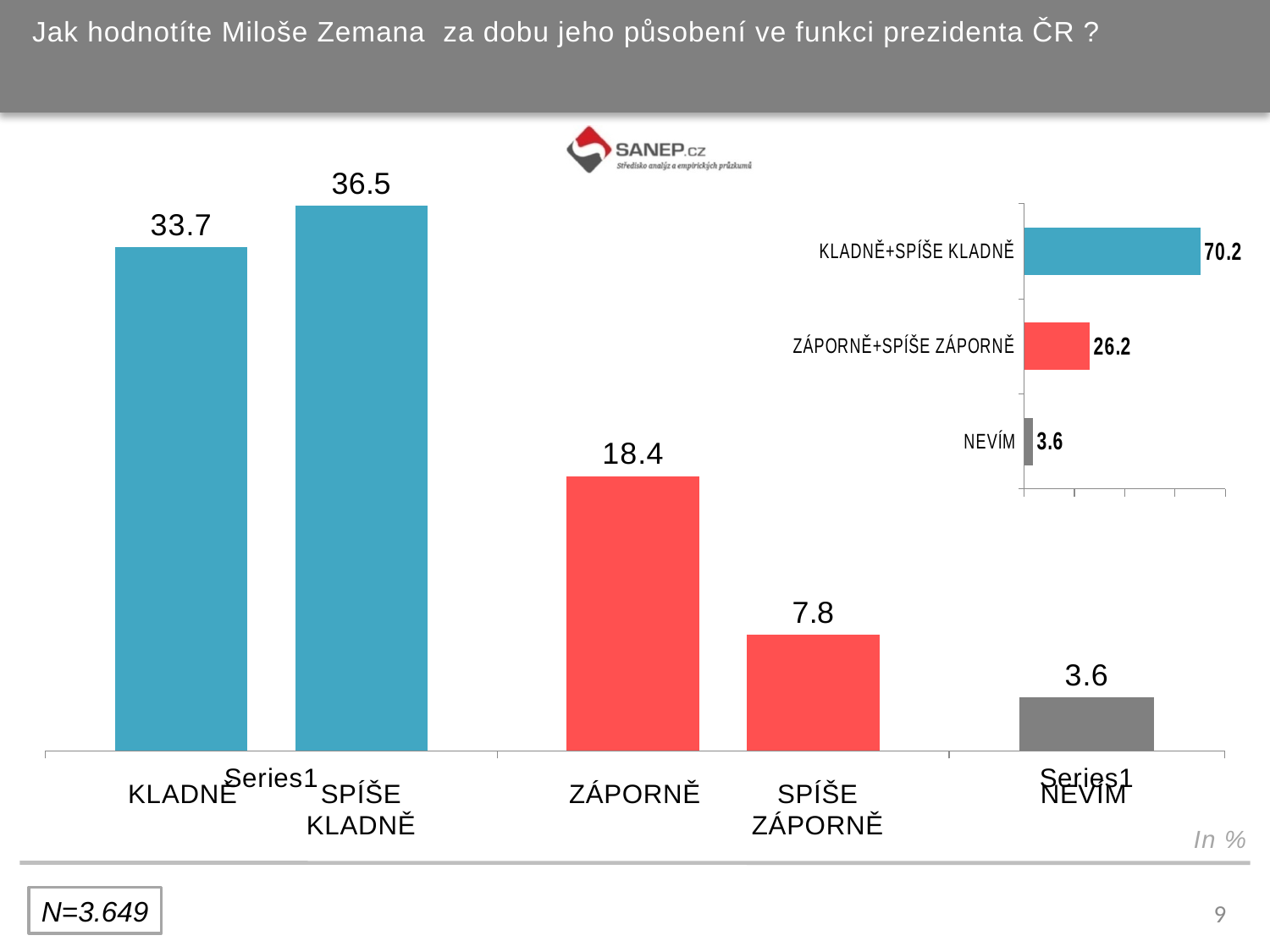
How many categories are shown in the large bar chart? 5 In the large bar chart, which is larger, the value for ZÁPORNĚ or the value for SPÍŠE ZÁPORNĚ? ZÁPORNĚ What kind of chart is the large chart on the left? bar chart In the large bar chart, what is the value for NEVÍM? 3.6 In the large bar chart, what is the value for ZÁPORNĚ? 18.4 In the small chart on the right, what is the value for KLADNĚ+SPÍŠE KLADNĚ? 70.2 In the large bar chart, which category has the highest value? SPÍŠE KLADNĚ In the large bar chart, which category has the lowest value? NEVÍM In the large bar chart, what is the difference between the values for SPÍŠE KLADNĚ and KLADNĚ? 2.8 In the small chart on the right, what is the difference between KLADNĚ+SPÍŠE KLADNĚ and ZÁPORNĚ+SPÍŠE ZÁPORNĚ? 44.0 In the large bar chart, what is the value for SPÍŠE KLADNĚ? 36.5 How many categories are shown in the small chart on the right? 3